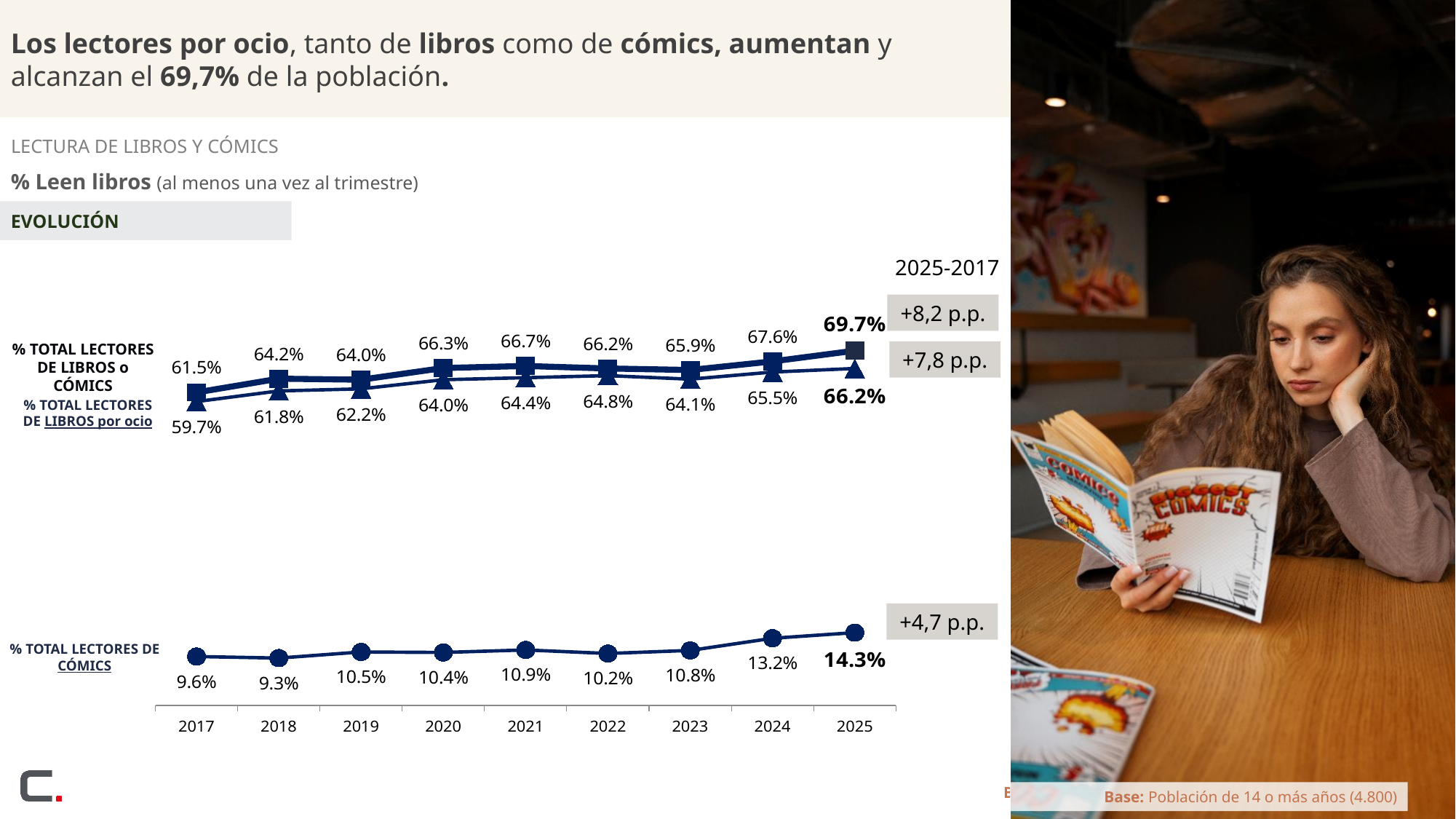
How many series are plotted in the chart? 3 Which is larger: % TOTAL LECTORES DE LIBROS por ocio in 2022 or in 2023? 2022 What is the value for % TOTAL LECTORES DE LIBROS o CÓMICS in 2025? 69.7% In which year is the % TOTAL LECTORES DE LIBROS o CÓMICS series highest? 2025 What kind of chart is shown on the slide? line chart What change from 2017 to 2025 is shown for the % TOTAL LECTORES DE LIBROS por ocio series? +7,8 p.p. In which year is the % TOTAL LECTORES DE CÓMICS series lowest? 2018 What is the difference between the % TOTAL LECTORES DE CÓMICS values for 2025 and 2017? 4.7 percentage points How many years are shown on the x axis? 9 Does the % TOTAL LECTORES DE CÓMICS series rise or fall between 2023 and 2025? rise What is the value for % TOTAL LECTORES DE LIBROS por ocio in 2017? 59.7% What is the value for % TOTAL LECTORES DE CÓMICS in 2024? 13.2%